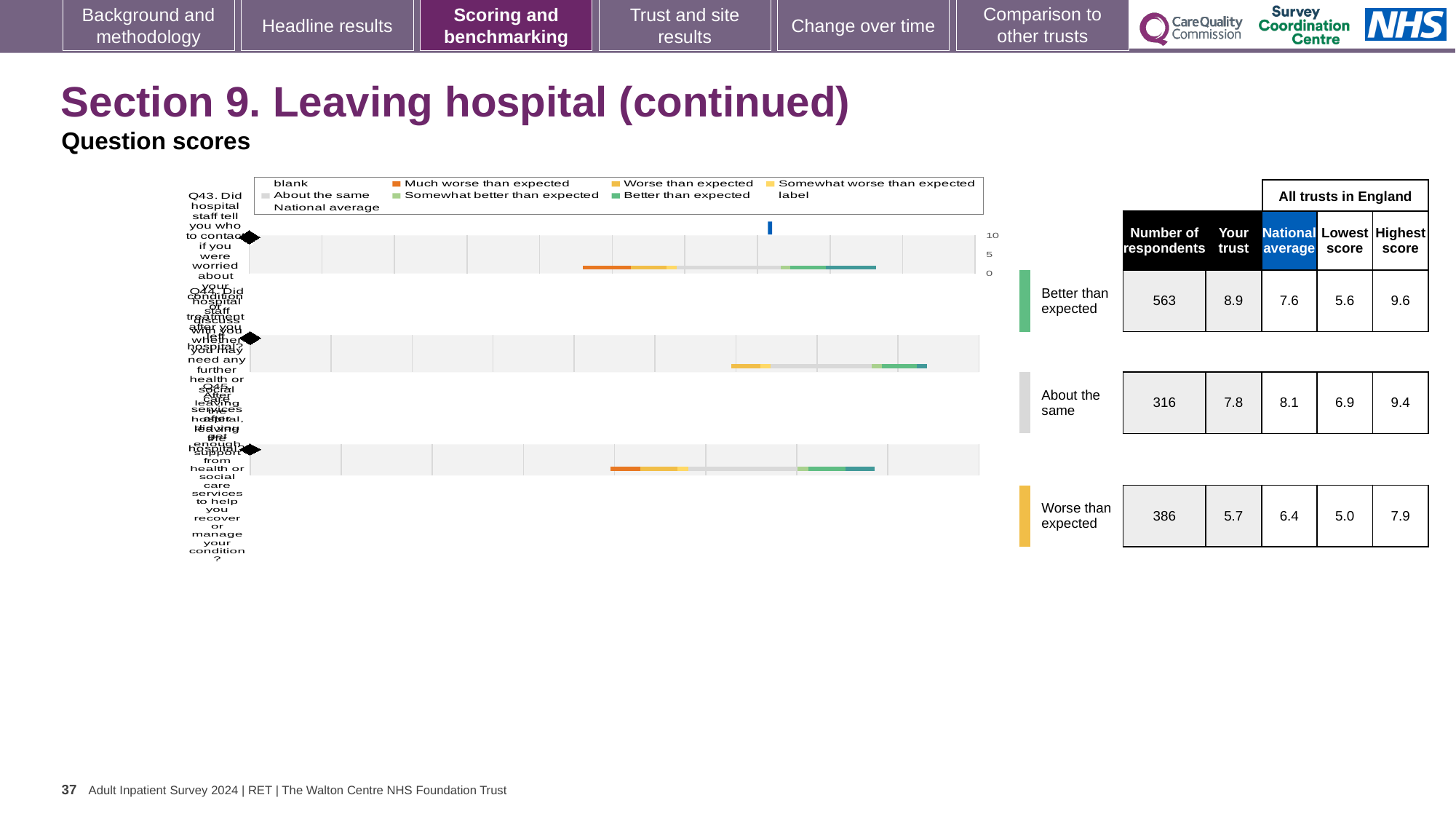
What kind of chart is used to show the question scores? Bar chart What is the 'Your trust' score for Q43? 8.9 Which question has the lowest 'Your trust' score? Q45 How many respondents are shown for Q43 (Did hospital staff tell you who to contact if you were worried about your condition or treatment after you left hospital)? 563 How many questions are plotted on the chart? 3 Which question has the highest 'Your trust' score? Q43 What is the highest score among all trusts in England for Q43? 9.6 For Q44, which is larger: the 'Your trust' score or the national average? National average What benchmark category is Q45 assigned to? Worse than expected What is the lowest score among all trusts in England for Q45 (After leaving hospital, did you get enough support from health or social care services)? 5.0 What is the national average score for Q44 (Did hospital staff discuss with you whether you may need any further health or social care services after leaving hospital)? 8.1 What is the difference between the national average and the 'Your trust' score for Q45? 0.7